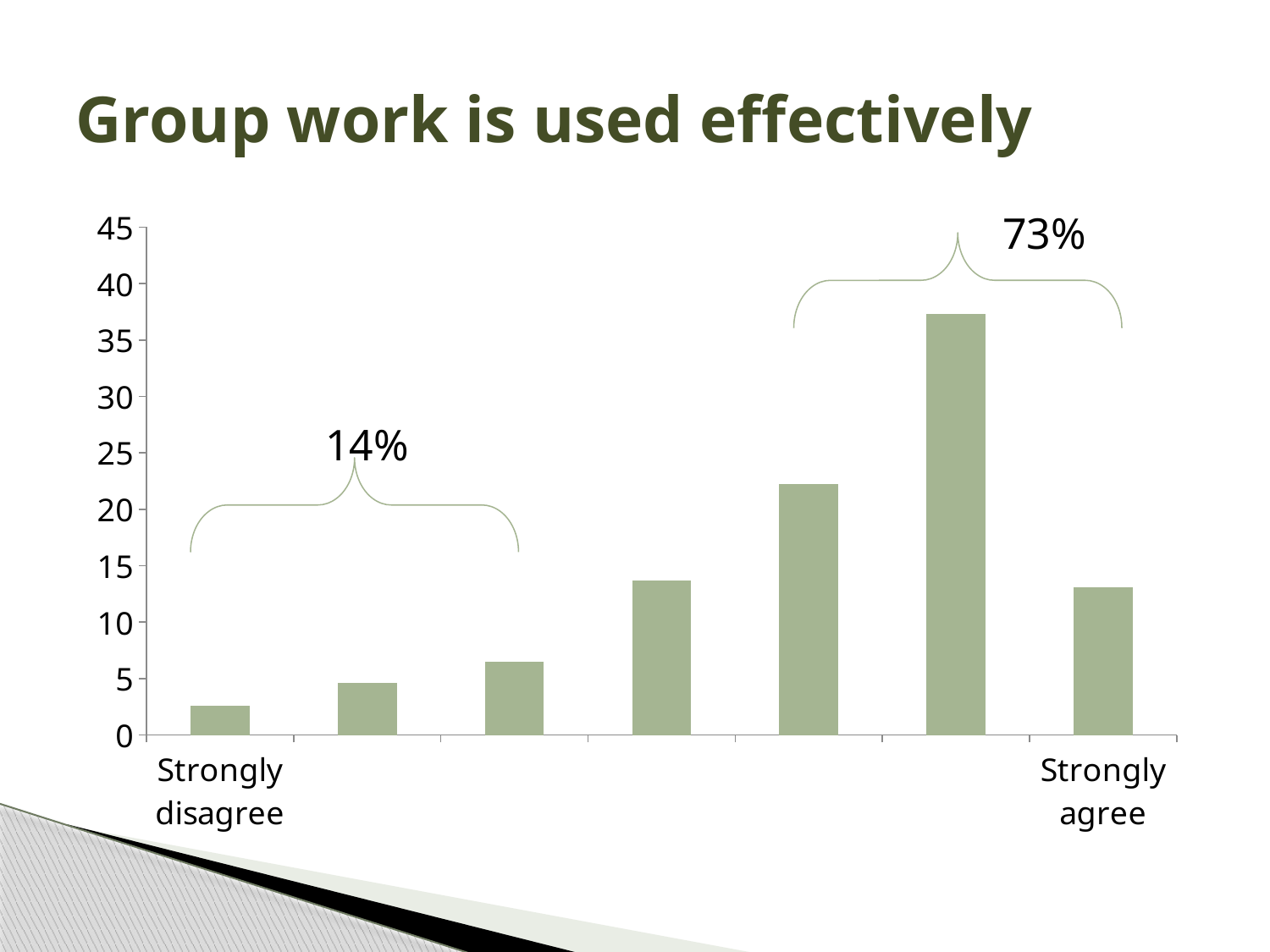
What kind of chart is shown on the slide? bar chart Is the value for Strongly agree greater or less than 15? less How many bars are plotted in the chart? 7 Which labelled category has the lowest value, Strongly disagree or Strongly agree? Strongly disagree Is the value for Strongly disagree greater or less than 5? less What is the highest tick value shown on the vertical axis? 45 Which is larger, the value for Strongly agree or the value for Strongly disagree? Strongly agree Is the tallest bar in the chart the Strongly agree bar? No Is the value for Strongly agree greater or less than 10? greater What percentage is written above the bracket grouping the three leftmost bars? 14% What percentage is written above the bracket grouping the three rightmost bars? 73%